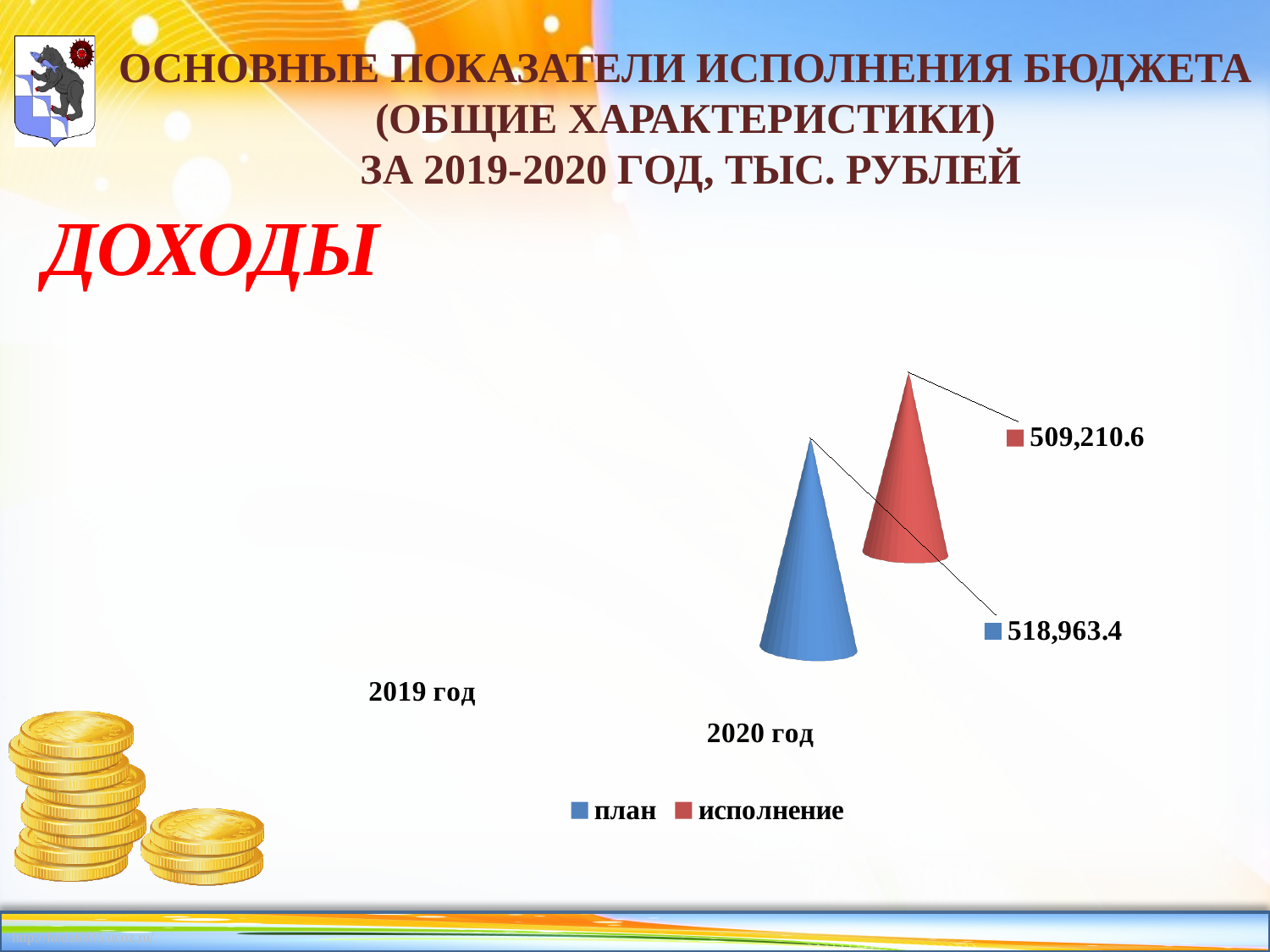
What is the difference between план and исполнение for 2020 год? 9,752.8 Which series has the lowest value shown on the chart? исполнение For 2020 год, which is larger: план or исполнение? план Which series has the highest value shown on the chart? план How many series does the legend list? 2 What colour represents the исполнение series? Red What are the two series named in the legend? план and исполнение How many year categories are labelled on the x axis? 2 What is the value of исполнение (execution) for 2020 год? 509,210.6 What kind of chart is shown on the slide? Bar chart What is the value of план (plan) for 2020 год? 518,963.4